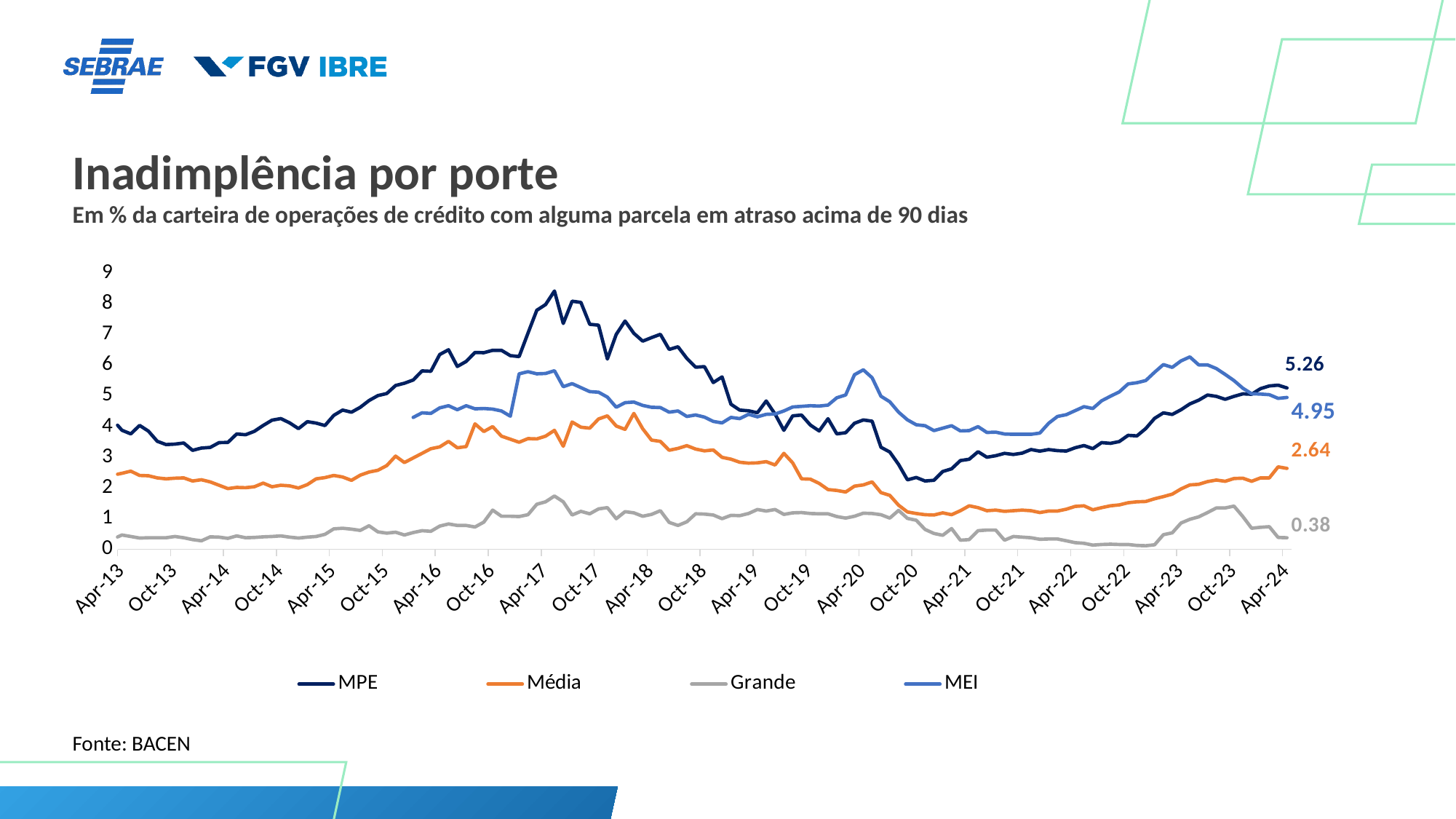
Which series has the highest labelled value at the end of the chart? MPE What is the value labelled for the Grande series at the end of the chart (Apr-24)? 0.38 Which series has the lowest labelled value at the end of the chart? Grande What is the value labelled for the MPE series at the end of the chart (Apr-24)? 5.26 What is the value labelled for the MEI series at the end of the chart (Apr-24)? 4.95 What is the value labelled for the Média series at the end of the chart (Apr-24)? 2.64 What kind of chart is shown on the slide? Line chart What is the difference between the final labelled values of MPE and MEI? 0.31 How many series does the legend list? 4 At the end of the chart, which is larger: the Média value or the Grande value? Média Is the peak value of the MPE series around Apr-17 greater or less than 7? greater Does the MPE series rise or fall between Apr-17 and Oct-20? Fall